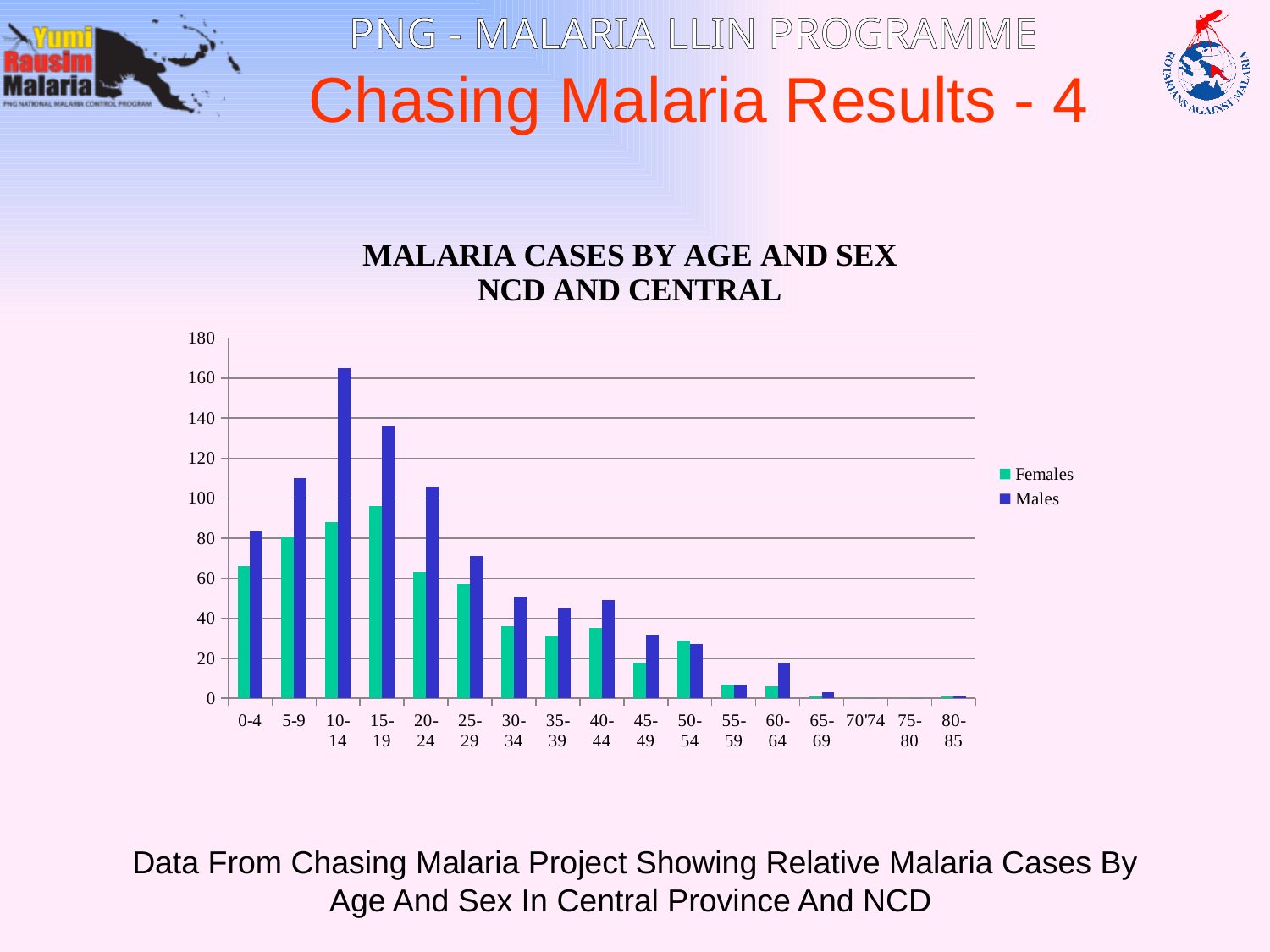
What kind of chart is shown on the slide? bar chart Which age group has the highest value for Males? 10-14 Is the value for Males in the 10-14 age group greater or less than 140? greater Is the value for Females in the 15-19 age group greater or less than 80? greater In the 20-24 age group, which is larger, Females or Males? Males How many age groups are shown on the x axis? 17 Is the value for Females in the 30-34 age group greater or less than 60? less Which age group has the highest value for Females? 15-19 What is the title of the chart? MALARIA CASES BY AGE AND SEX NCD AND CENTRAL Do the values for Males rise or fall from the 15-19 age group to the 45-49 age group? fall How many series does the legend list? 2